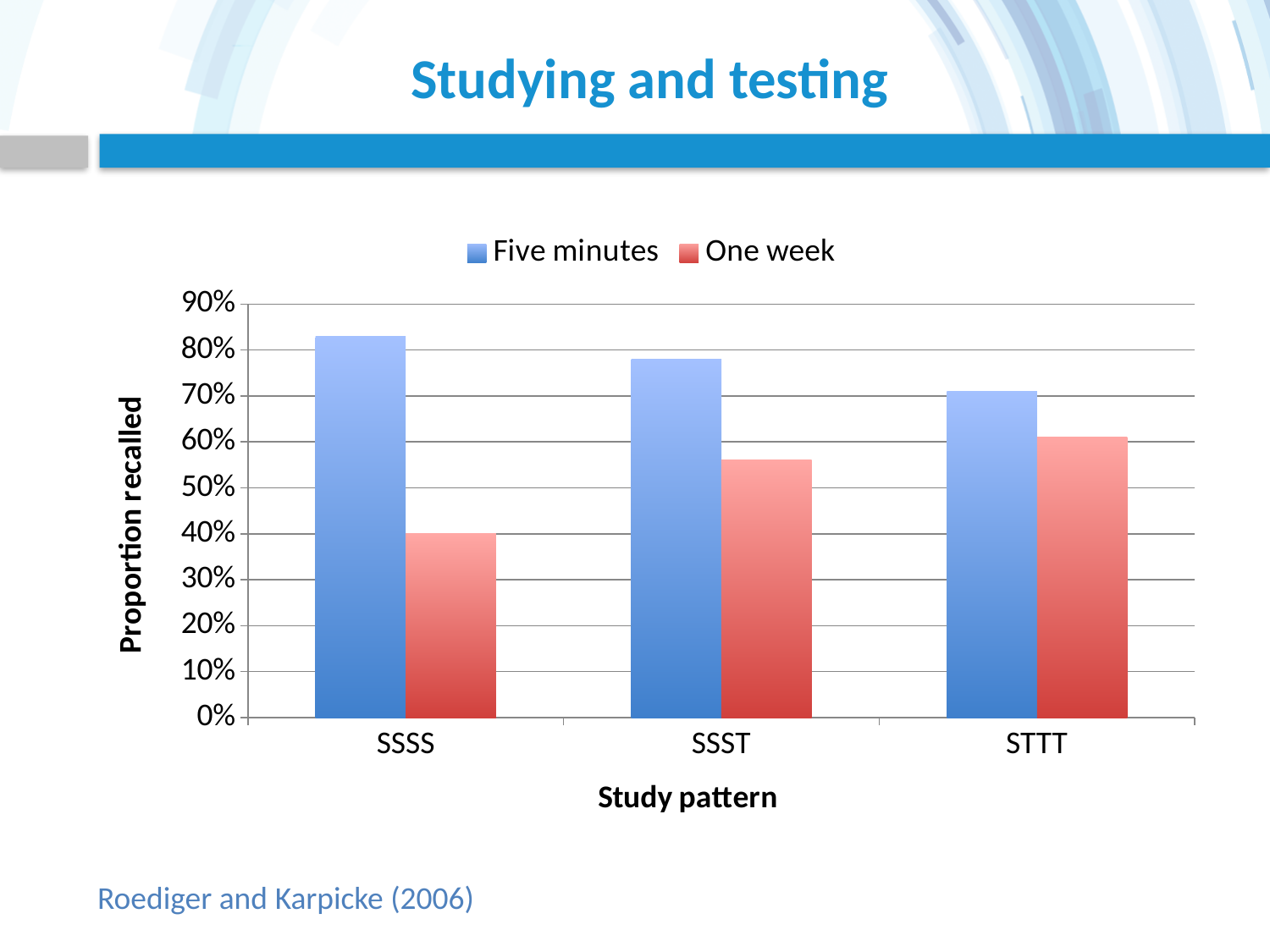
How many series does the legend list? 2 Is the Five minutes value for SSSS greater or less than 80%? greater Do the Five minutes values rise or fall from SSSS to STTT? fall What is the title of the y axis? Proportion recalled How many study patterns are shown on the x axis? 3 What kind of chart is shown on the slide? Bar chart Which study pattern has the highest value for the Five minutes series? SSSS Is the One week value for SSST greater or less than 50%? greater Is the Five minutes value for STTT greater or less than 80%? less Which study pattern has the highest value for the One week series? STTT Which study pattern has the lowest value for the One week series? SSSS For SSSS, which is larger: the Five minutes value or the One week value? Five minutes